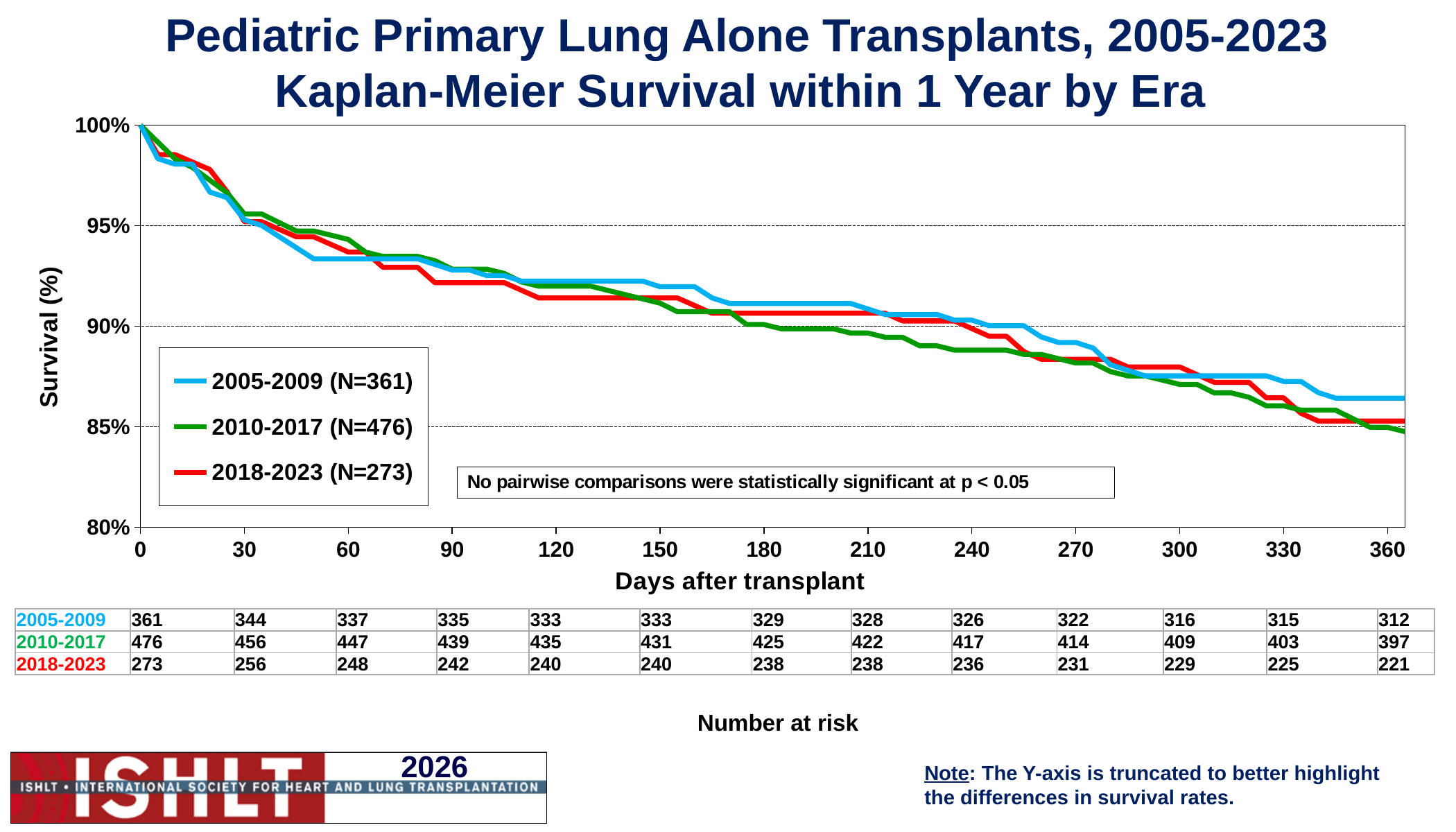
Is the survival value for the 2005-2009 era at day 180 greater or less than 90%? greater Which era has the smallest number of transplants (N) in the legend? 2018-2023 (N=273) In the number at risk table, which era has more patients at risk at day 360: 2005-2009 or 2010-2017? 2010-2017 In the number at risk table, how many patients in the 2005-2009 era were at risk at day 360? 312 Do the survival curves rise or fall as days after transplant increase? fall How many series does the legend list? 3 Is the survival value for the 2005-2009 era at day 360 greater or less than 85%? greater In the number at risk table, what is the difference between the 2010-2017 number at risk at day 0 and at day 360? 79 Which era has the largest number of transplants (N) in the legend? 2010-2017 (N=476) What kind of chart is shown on the slide? line chart In the number at risk table, how many patients in the 2018-2023 era were at risk at day 180? 238